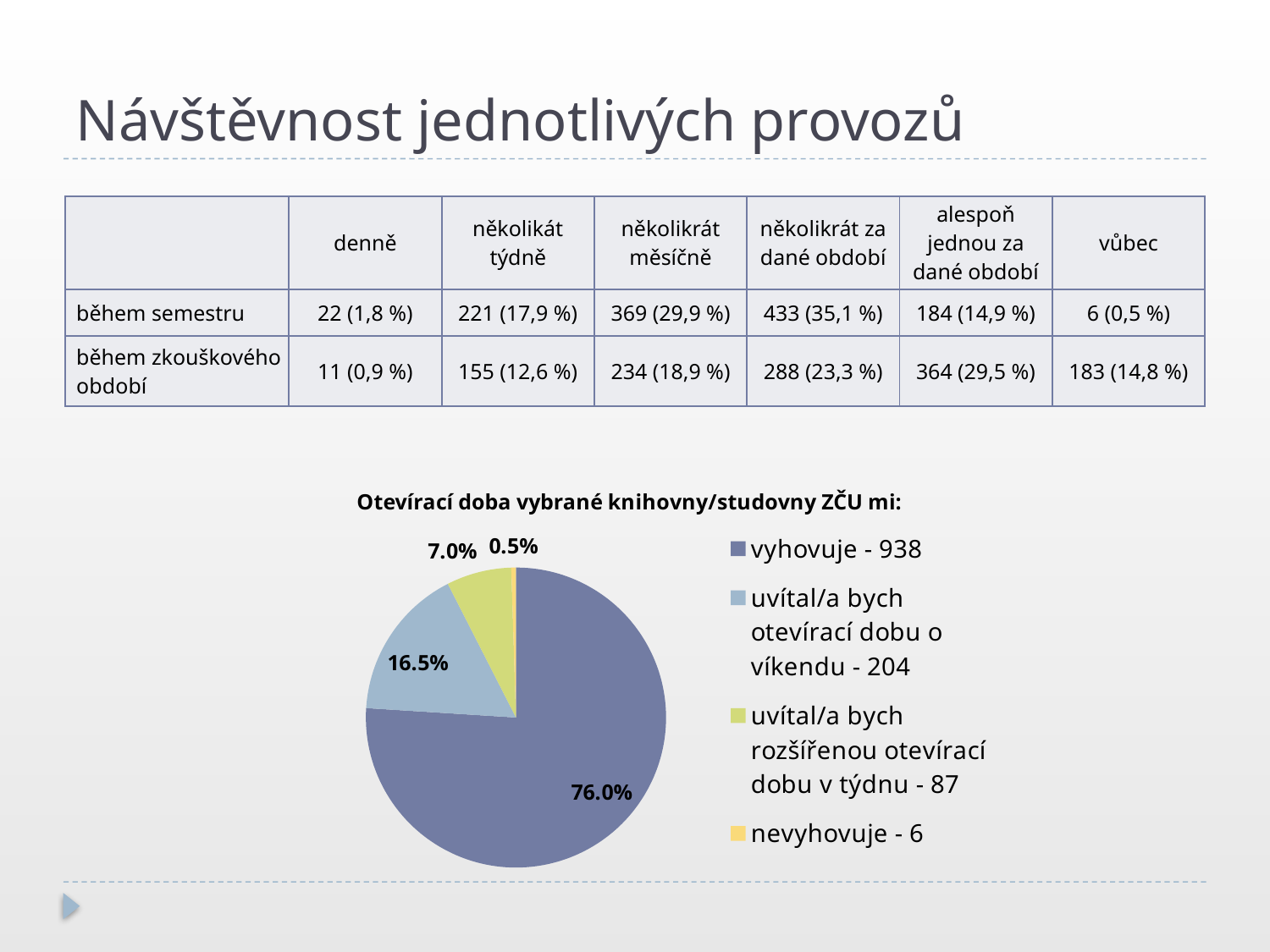
How many slices does the pie chart have? 4 What share of the pie does the 'vyhovuje - 938' slice represent? 76.0% What share of the pie does the 'uvítal/a bych otevírací dobu o víkendu - 204' slice represent? 16.5% What is the difference in percentage points between the 'vyhovuje' slice and the 'uvítal/a bych otevírací dobu o víkendu' slice? 59.5 percentage points Which slice of the pie chart is the smallest? nevyhovuje - 6 Which is larger: the 'uvítal/a bych otevírací dobu o víkendu' slice or the 'uvítal/a bych rozšířenou otevírací dobu v týdnu' slice? uvítal/a bych otevírací dobu o víkendu What share of the pie does the 'uvítal/a bych rozšířenou otevírací dobu v týdnu - 87' slice represent? 7.0% What kind of chart is shown on the slide? pie chart Which slice of the pie chart is the largest? vyhovuje - 938 What colour is the 'nevyhovuje - 6' slice in the legend? yellow What is the title of the pie chart? Otevírací doba vybrané knihovny/studovny ZČU mi: